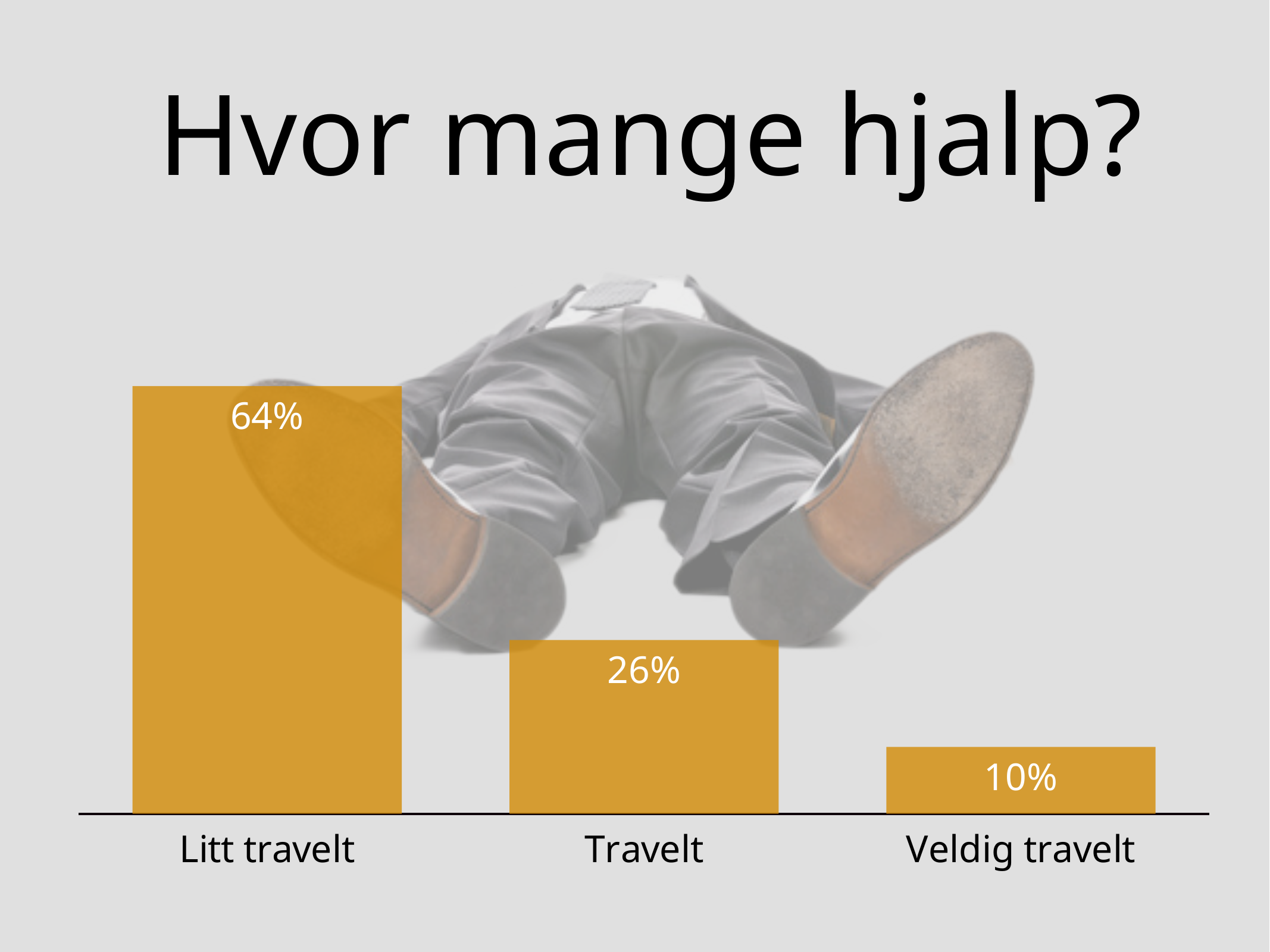
Do the values rise or fall from left to right across the categories? Fall Which is larger, the value for Travelt or the value for Veldig travelt? Travelt What is the value for Travelt? 26% What is the title of the slide? Hvor mange hjalp? What is the difference between the values for Travelt and Veldig travelt? 16% What is the value for Veldig travelt? 10% What kind of chart is shown on the slide? Bar chart Which category has the lowest value? Veldig travelt What is the difference between the values for Litt travelt and Travelt? 38% Which category has the highest value? Litt travelt What is the value for Litt travelt? 64% How many categories are shown in the chart? 3